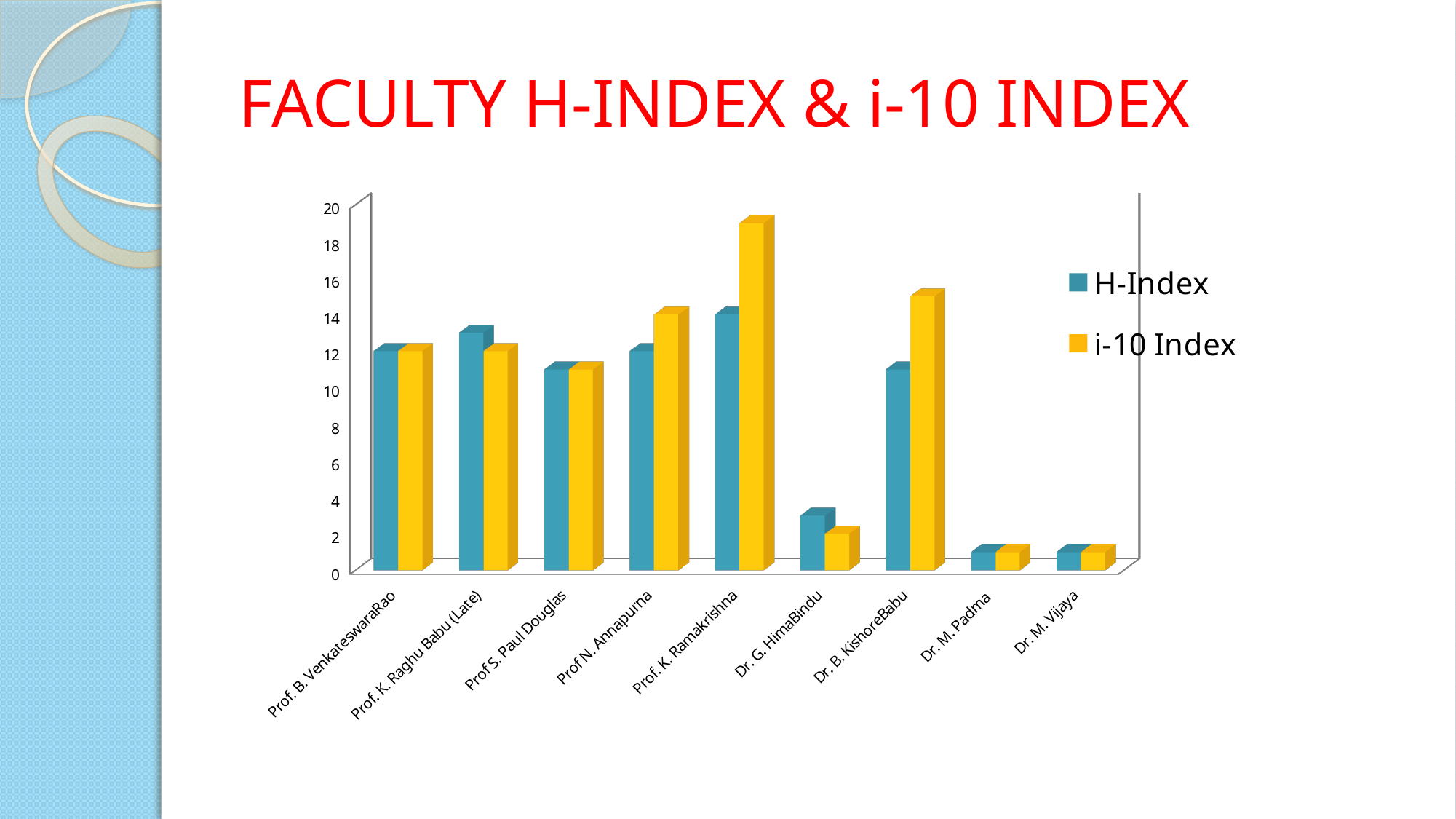
For Dr. G. HimaBindu, which is larger, the H-Index or the i-10 Index? H-Index For Dr. B. KishoreBabu, which is larger, the H-Index or the i-10 Index? i-10 Index Is the i-10 Index for Prof. K. Ramakrishna greater or less than 18? greater How many series does the legend list? 2 Which faculty member has the highest H-Index? Prof. K. Ramakrishna How many faculty members are shown on the x axis? 9 Which series is shown in yellow? i-10 Index Which faculty member has the highest i-10 Index? Prof. K. Ramakrishna What is the title of the slide? FACULTY H-INDEX & i-10 INDEX Is the H-Index for Dr. G. HimaBindu greater or less than 4? less What kind of chart is shown on the slide? bar chart Is the i-10 Index for Dr. B. KishoreBabu greater or less than 14? greater